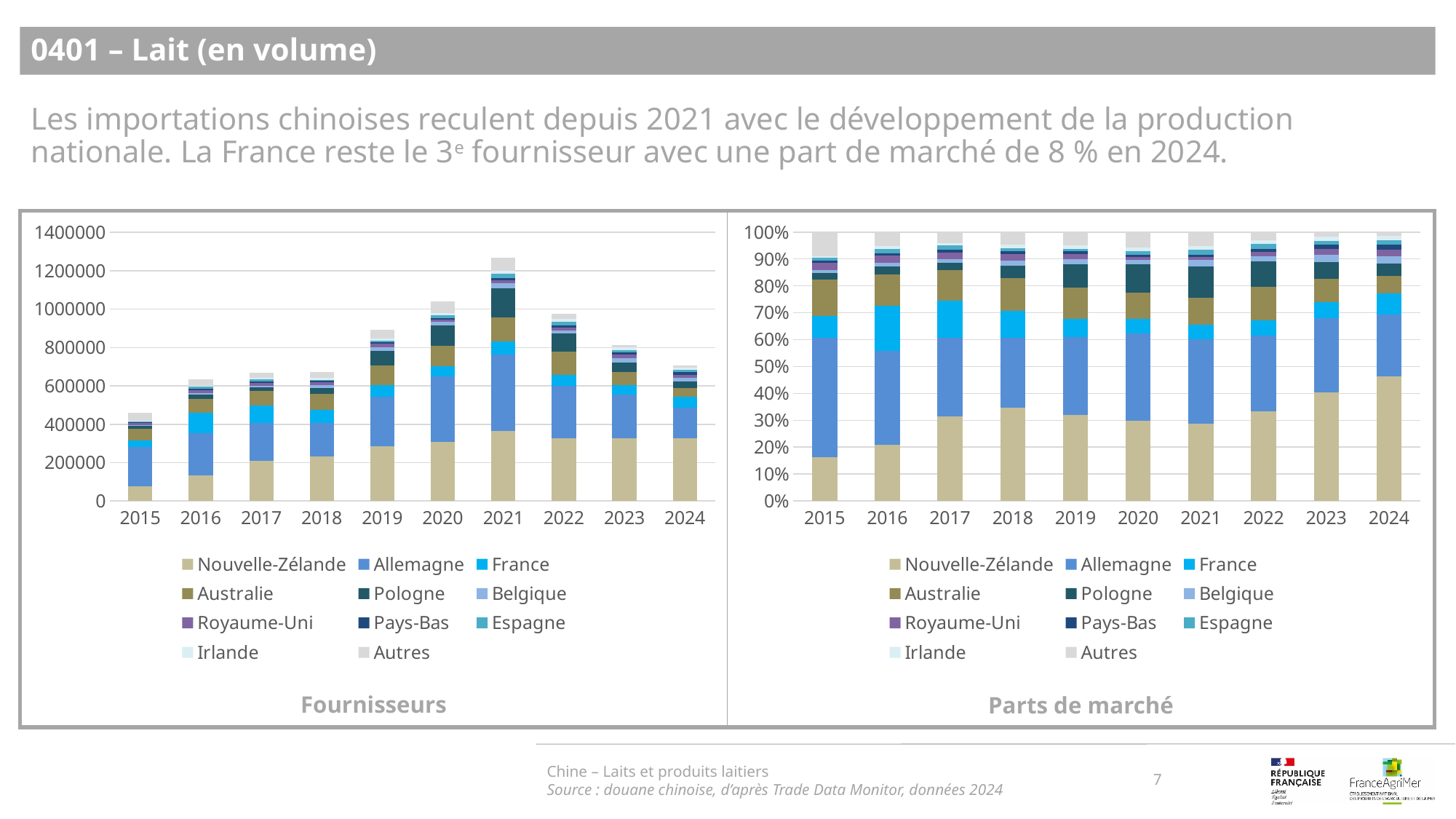
How many series does the legend of the 'Parts de marché' chart list? 11 In the 'Parts de marché' chart, does the share of Nouvelle-Zélande rise or fall from 2021 to 2024? rise In the 'Fournisseurs' chart, is the total bar for 2015 greater or less than 600000? less What kind of chart is the 'Fournisseurs' chart on the left? Stacked bar chart In the 'Fournisseurs' chart, which year has the highest total import volume? 2021 In the 'Parts de marché' chart, is the share of Nouvelle-Zélande in 2024 greater or less than 60%? less In the 'Fournisseurs' chart, is the total bar for 2024 greater or less than 800000? less In the 'Fournisseurs' chart, which year has the lowest total import volume? 2015 How many years are shown on the x axis of the 'Fournisseurs' chart? 10 In the 'Fournisseurs' chart, does the total import volume rise or fall from 2021 to 2024? fall